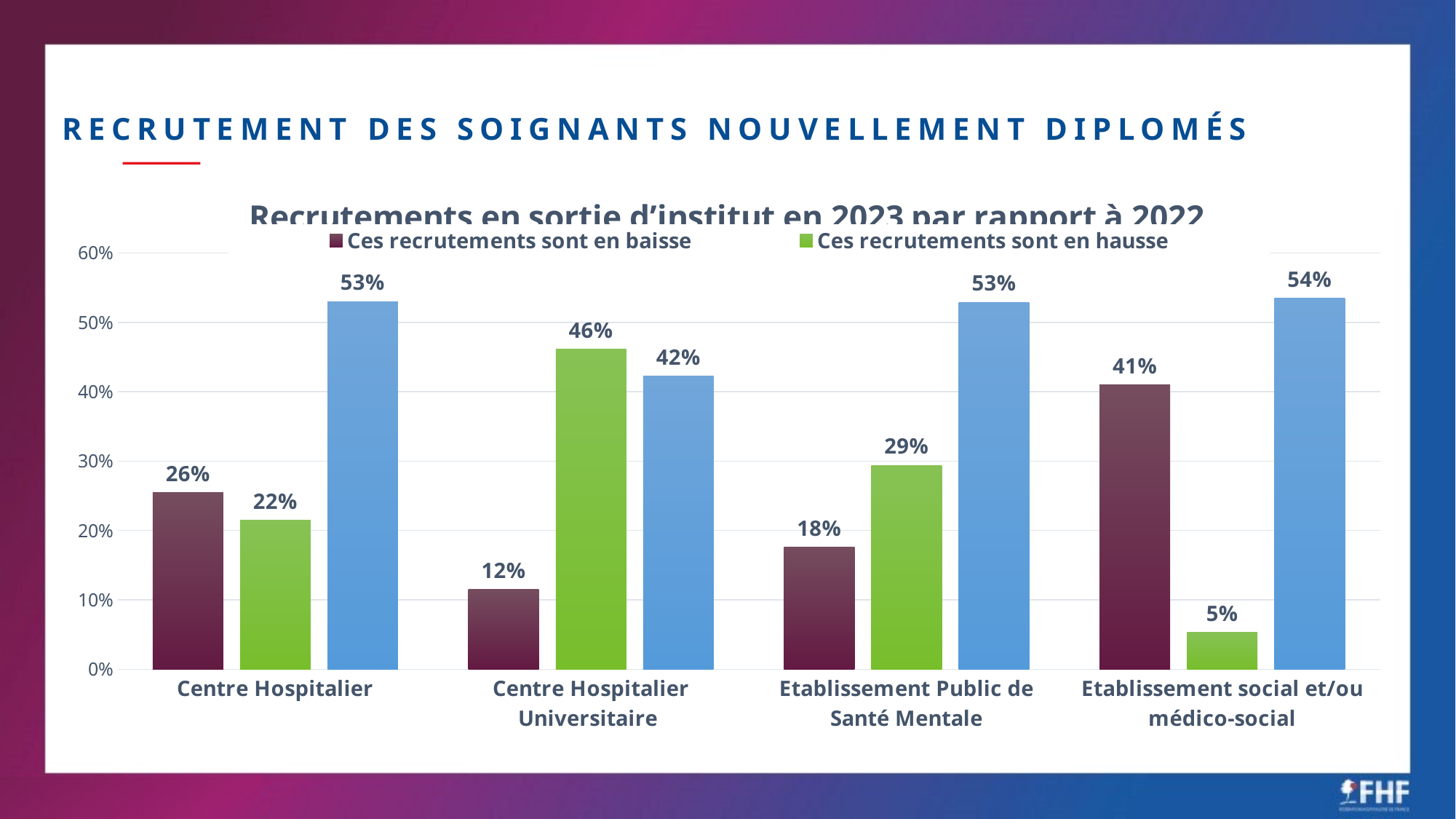
What is the value of "Ces recrutements sont en hausse" for Centre Hospitalier Universitaire? 46% Which category has the highest value for "Ces recrutements sont en baisse"? Etablissement social et/ou médico-social For Centre Hospitalier, which is larger: "Ces recrutements sont en baisse" or "Ces recrutements sont en hausse"? Ces recrutements sont en baisse For Centre Hospitalier Universitaire, what is the difference between "Ces recrutements sont en hausse" and "Ces recrutements sont en baisse"? 34 percentage points How many categories are shown on the x axis of the chart? 4 Which category has the lowest value for "Ces recrutements sont en hausse"? Etablissement social et/ou médico-social Which category has the highest value for "Ces recrutements sont en hausse"? Centre Hospitalier Universitaire What kind of chart is shown on the slide? Bar chart What colour represents "Ces recrutements sont en hausse" in the chart? Green What is the value of "Ces recrutements sont en baisse" for Centre Hospitalier? 26% What is the value of "Ces recrutements sont en hausse" for Etablissement social et/ou médico-social? 5% What is the value of "Ces recrutements sont en baisse" for Etablissement Public de Santé Mentale? 18%